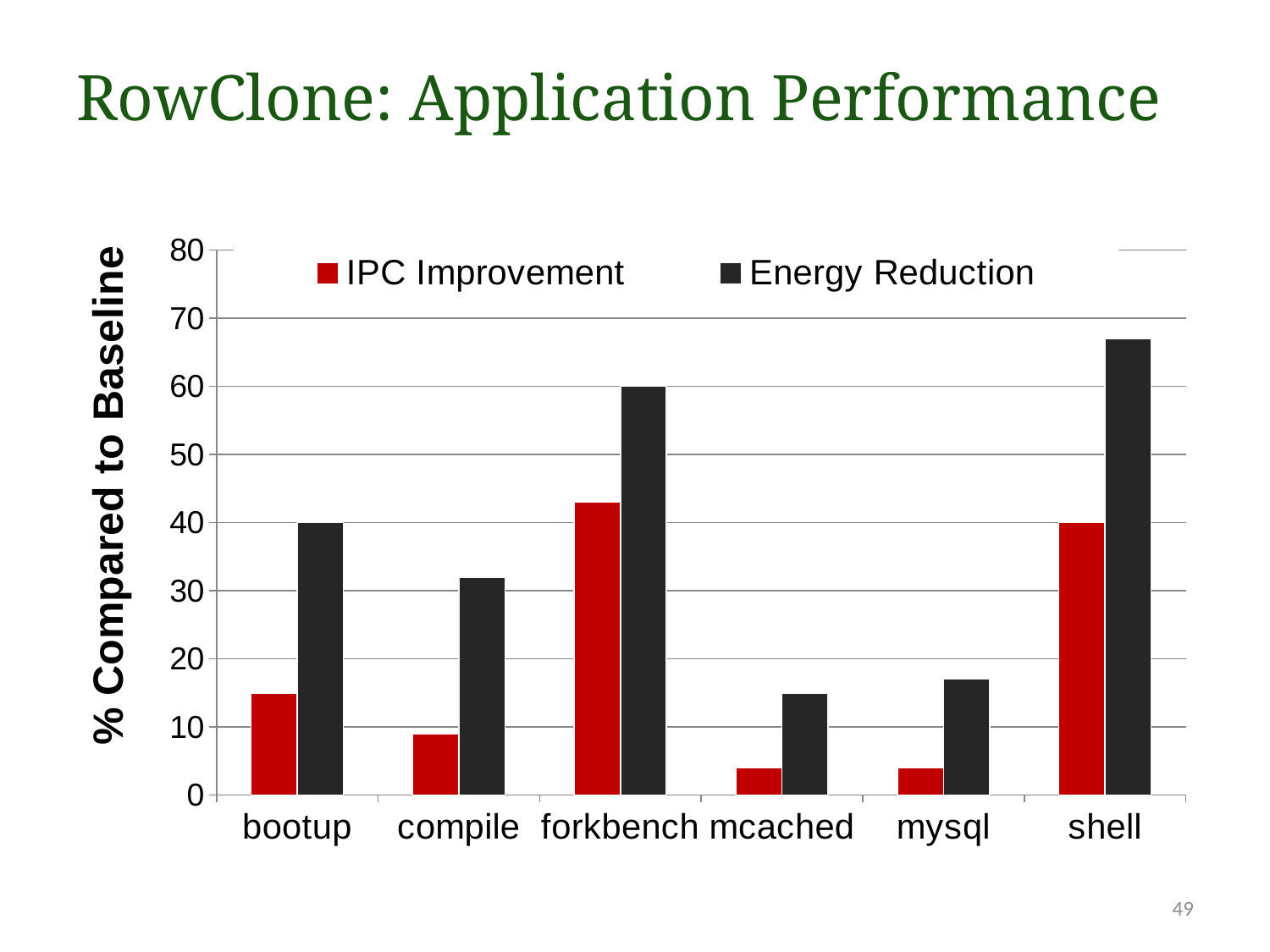
Which is larger: the Energy Reduction for forkbench or the Energy Reduction for shell? shell Is the IPC Improvement for forkbench greater or less than 40? greater Is the IPC Improvement for mcached greater or less than 10? less Is the Energy Reduction for mysql greater or less than 20? less How many applications are shown on the x axis? 6 What is the label on the y axis? % Compared to Baseline How many series does the legend list? 2 Which application has the highest IPC Improvement? forkbench What kind of chart is shown on the slide? bar chart Which is larger: the Energy Reduction for bootup or the Energy Reduction for compile? bootup Which application has the highest Energy Reduction? shell